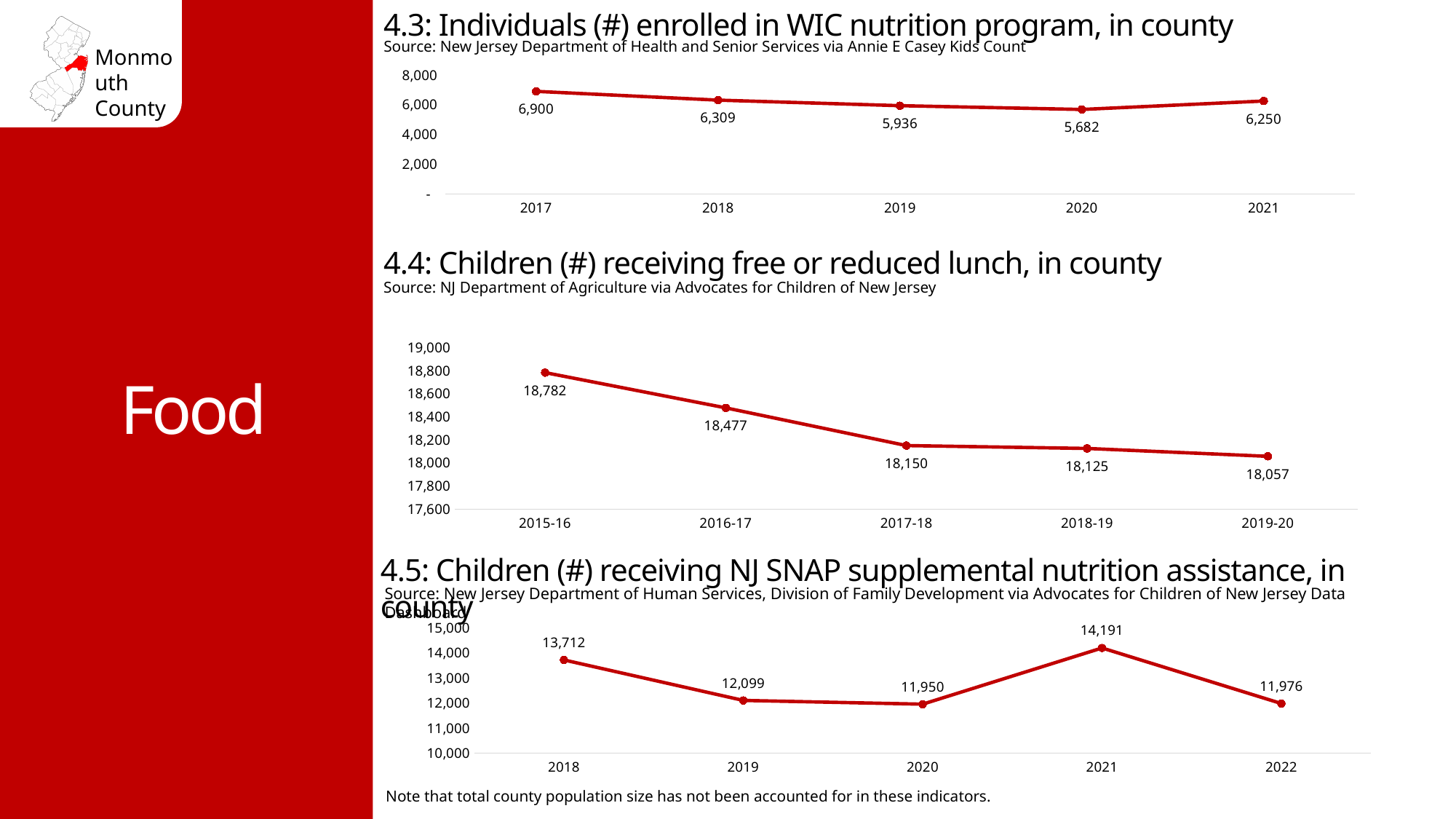
In the chart '4.3: Individuals (#) enrolled in WIC nutrition program, in county', what is the difference between the 2017 and 2021 values? 650 What kind of chart is '4.5: Children (#) receiving NJ SNAP supplemental nutrition assistance, in county'? line chart In the chart '4.5: Children (#) receiving NJ SNAP supplemental nutrition assistance, in county', what is the value for 2021? 14,191 In the chart '4.3: Individuals (#) enrolled in WIC nutrition program, in county', what is the value for 2017? 6,900 In the chart '4.4: Children (#) receiving free or reduced lunch, in county', do the values rise or fall from 2015-16 to 2019-20? fall In the chart '4.4: Children (#) receiving free or reduced lunch, in county', what is the difference between the 2015-16 and 2019-20 values? 725 In the chart '4.5: Children (#) receiving NJ SNAP supplemental nutrition assistance, in county', which year has the lowest value? 2020 In the chart '4.4: Children (#) receiving free or reduced lunch, in county', which school year has the highest value? 2015-16 In the chart '4.3: Individuals (#) enrolled in WIC nutrition program, in county', which year has the lowest value? 2020 In the chart '4.4: Children (#) receiving free or reduced lunch, in county', what is the value for 2016-17? 18,477 In the chart '4.5: Children (#) receiving NJ SNAP supplemental nutrition assistance, in county', is the value for 2018 greater or less than 13,000? greater In the chart '4.3: Individuals (#) enrolled in WIC nutrition program, in county', how many years are plotted? 5